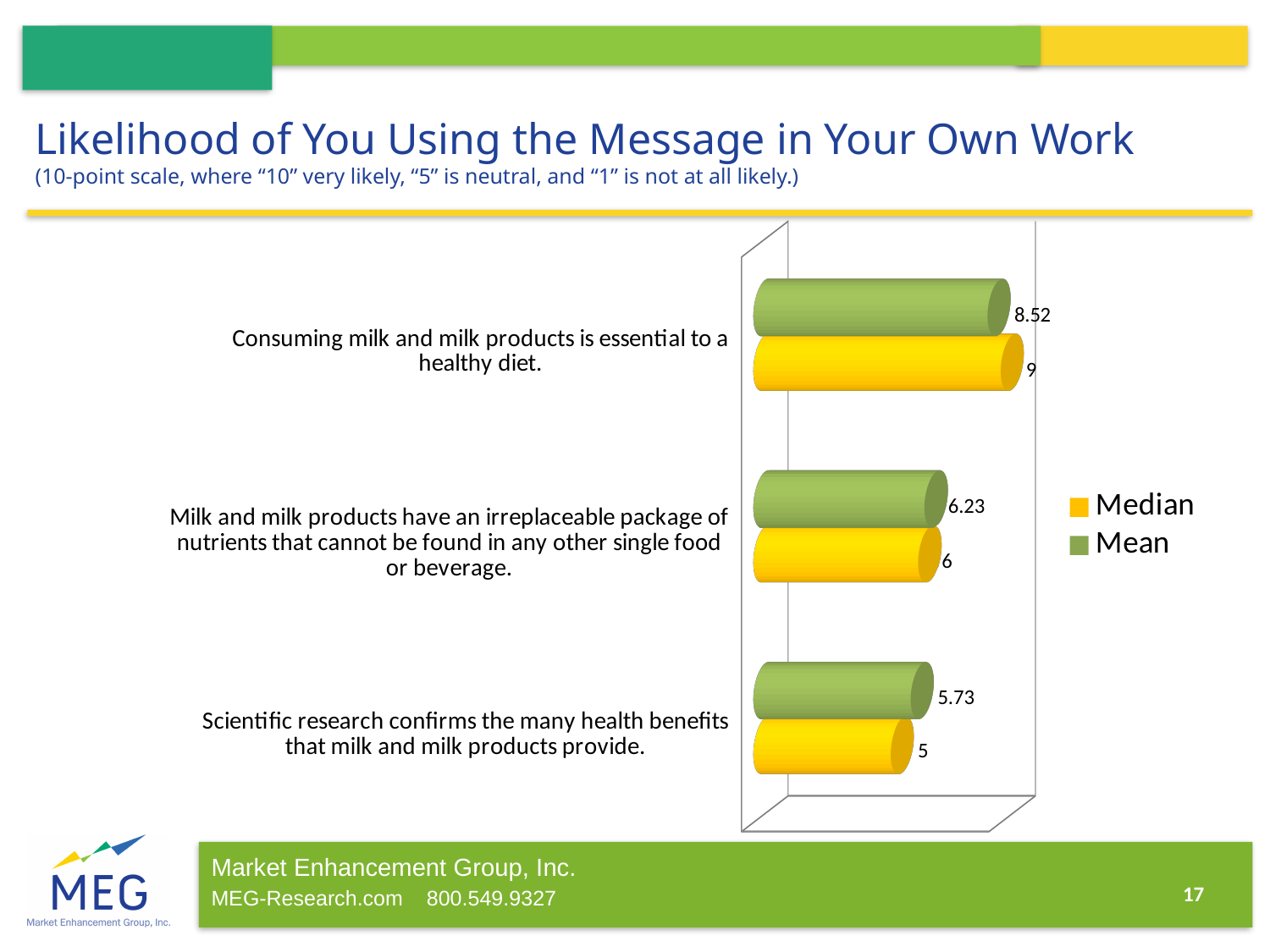
What is the Median value for "Scientific research confirms the many health benefits that milk and milk products provide."? 5 For "Milk and milk products have an irreplaceable package of nutrients that cannot be found in any other single food or beverage.", which is larger, the Mean or the Median? Mean What is the difference between the Median values for "Consuming milk and milk products is essential to a healthy diet." and "Milk and milk products have an irreplaceable package of nutrients that cannot be found in any other single food or beverage."? 3 Which message has the lowest Median value? Scientific research confirms the many health benefits that milk and milk products provide. What kind of chart is shown on the slide? Bar chart What is the Mean value for "Consuming milk and milk products is essential to a healthy diet."? 8.52 Which message has the highest Mean value? Consuming milk and milk products is essential to a healthy diet. What is the difference between the Mean values for "Consuming milk and milk products is essential to a healthy diet." and "Scientific research confirms the many health benefits that milk and milk products provide."? 2.79 How many messages (categories) are shown in the chart? 3 How many series does the legend list? 2 What is the Mean value for "Milk and milk products have an irreplaceable package of nutrients that cannot be found in any other single food or beverage."? 6.23 Which colour represents the Median series in the chart? Yellow